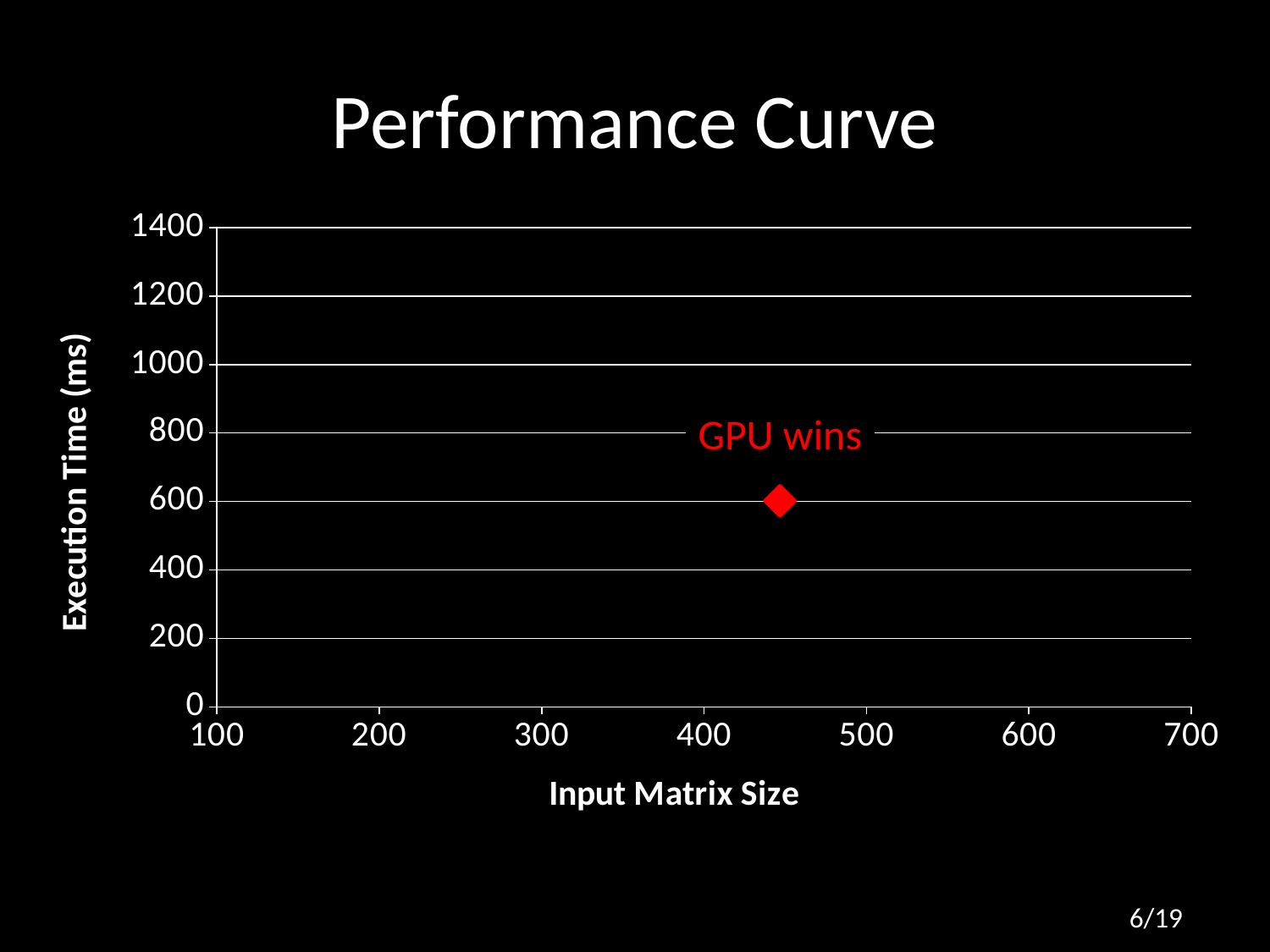
How many data points are plotted on the chart? 1 Is the input matrix size of the plotted point greater or less than 500? less Is the execution time of the plotted point greater or less than 1000? less What is the title of the chart? Performance Curve Is the execution time of the plotted point greater or less than 800? less What execution time (ms) does the plotted point land on? 600 What kind of chart is shown on the slide? scatter chart What text is annotated next to the plotted point? GPU wins